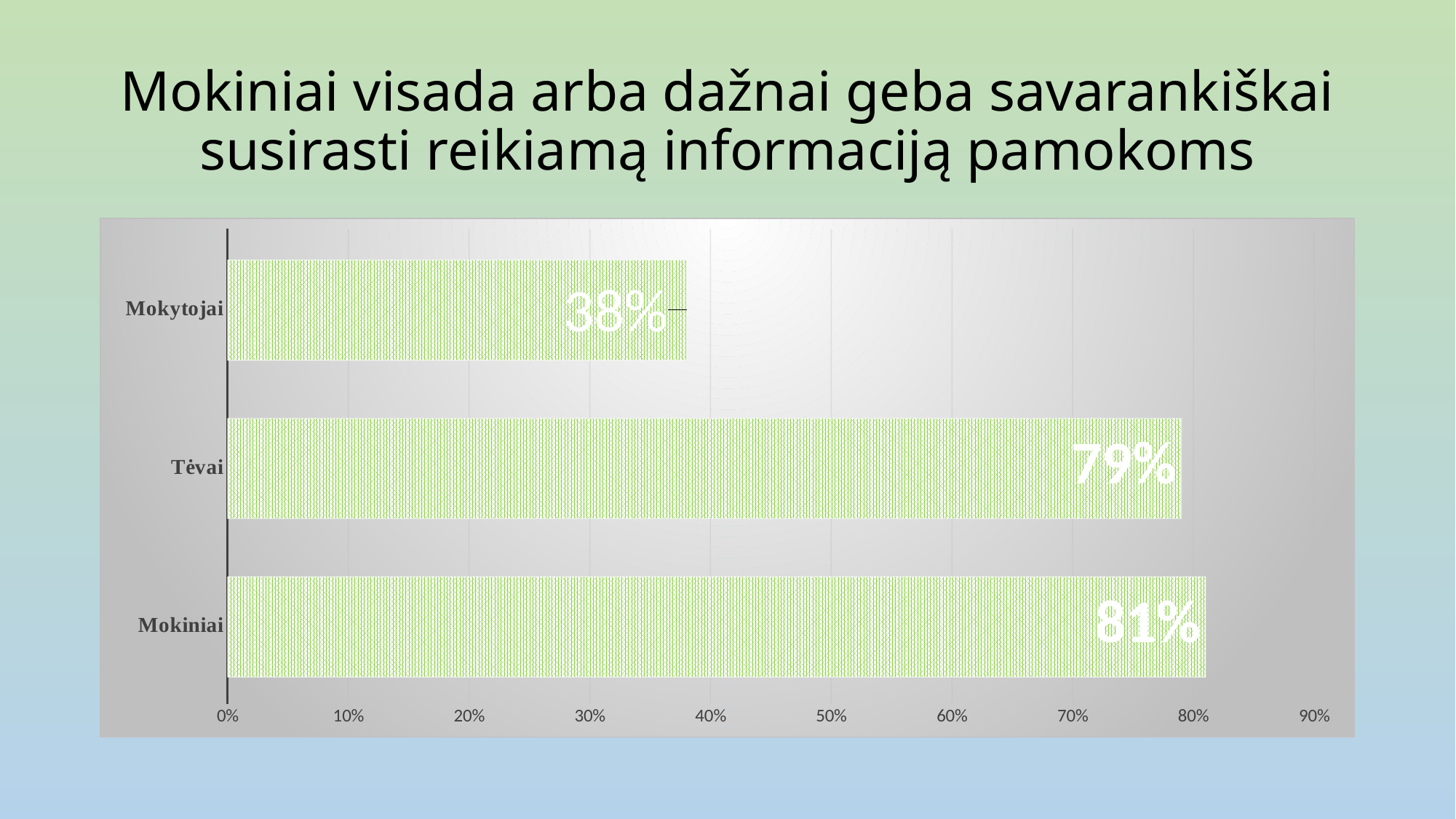
What is the difference between the values for Tėvai and Mokytojai? 41% Which category has the lowest value? Mokytojai What kind of chart is shown on the slide? bar chart Is the value for Mokytojai greater or less than 40%? less What is the value for Tėvai? 79% Which is larger, the value for Tėvai or the value for Mokytojai? Tėvai What is the difference between the values for Mokiniai and Mokytojai? 43% What is the highest value shown on the horizontal axis? 90% Which category has the highest value? Mokiniai What is the value for Mokiniai? 81% How many categories are shown in the chart? 3 What is the value for Mokytojai? 38%